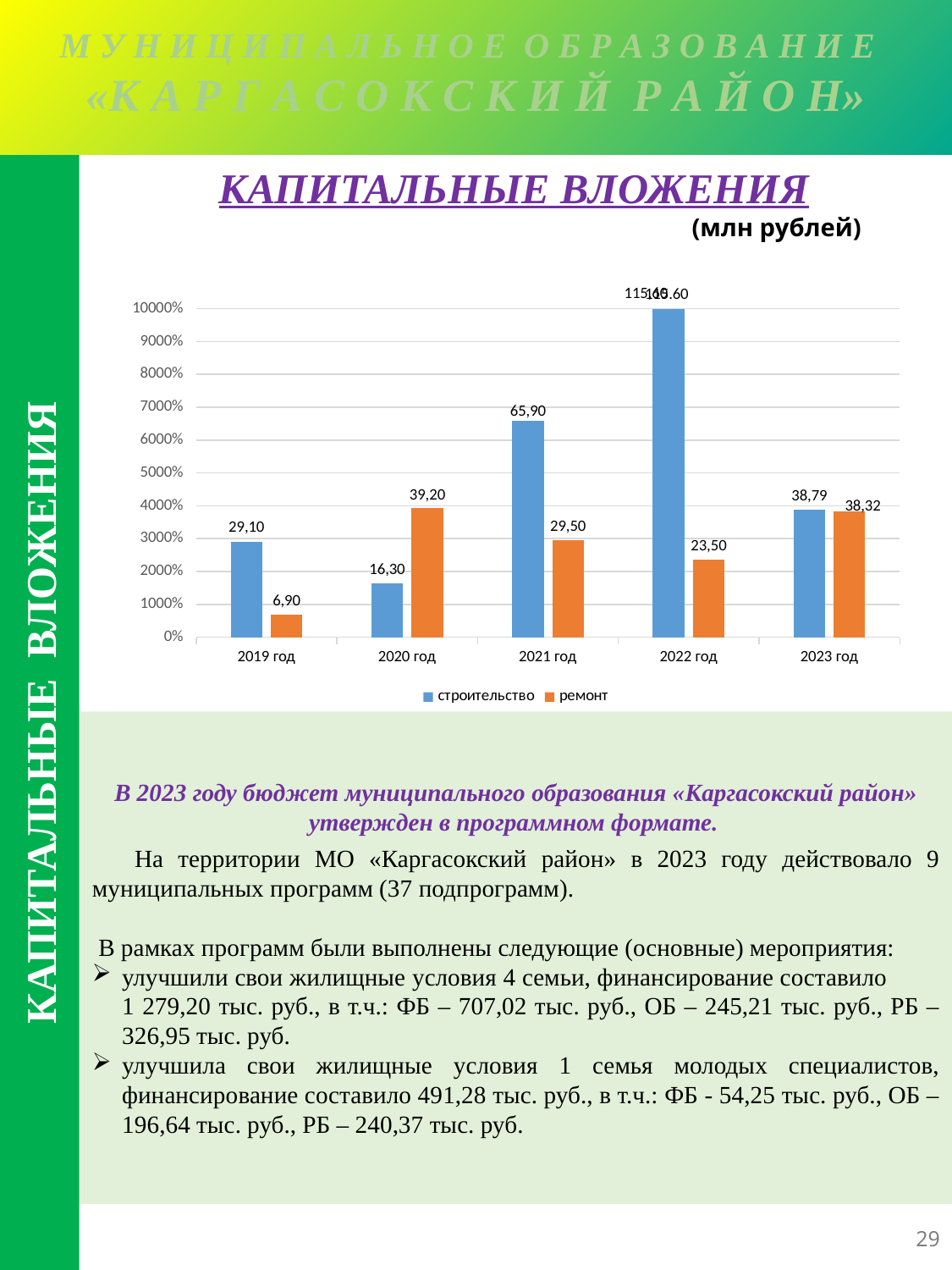
What is the value for ремонт in 2020 год? 39,20 What is the value for строительство in 2023 год? 38,79 What is the value for ремонт in 2022 год? 23,50 What is the value for строительство in 2021 год? 65,90 How many years (categories) are shown on the x axis of the chart? 5 What is the value for строительство in 2019 год? 29,10 What is the difference between строительство and ремонт in 2021 год? 36,40 How many series does the chart legend list? 2 In 2020 год, which is larger: строительство or ремонт? ремонт In which year is the value for ремонт the lowest? 2019 год What kind of chart is shown on the slide? bar chart In which year is the value for строительство the highest? 2022 год